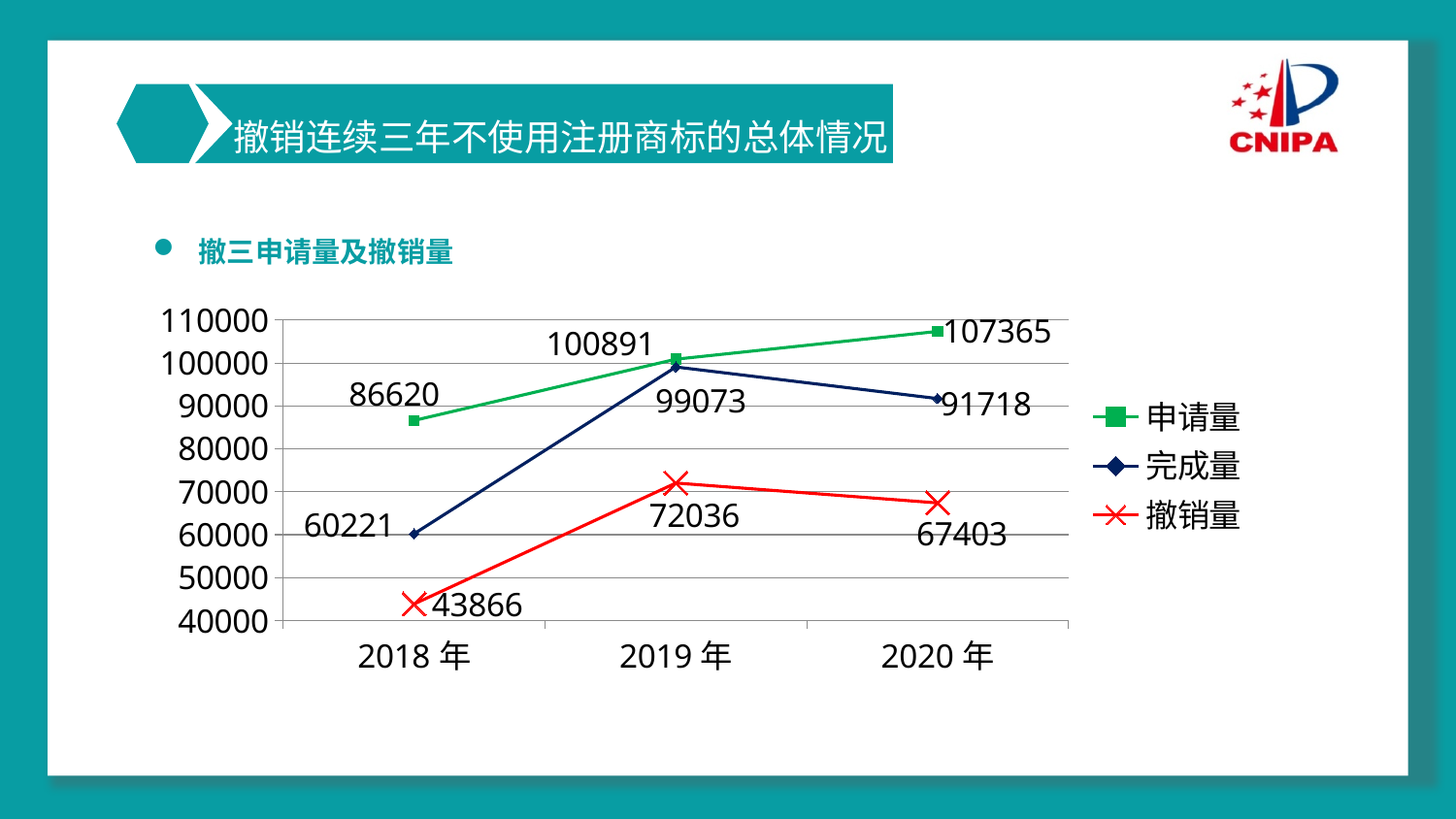
In which year is 完成量 the lowest? 2018年 What is the difference between 申请量 and 完成量 in 2020年? 15647 Which series is drawn with red X markers? 撤销量 Does 申请量 rise or fall from 2018年 to 2020年? rise What is the value of 完成量 in 2019年? 99073 What is the value of 撤销量 in 2020年? 67403 In which year is 撤销量 the highest? 2019年 Which is larger in 2019年, 申请量 or 撤销量? 申请量 What type of chart is shown on the slide? line chart How many years are shown on the x axis? 3 How many series does the legend list? 3 What is the value of 申请量 in 2018年? 86620